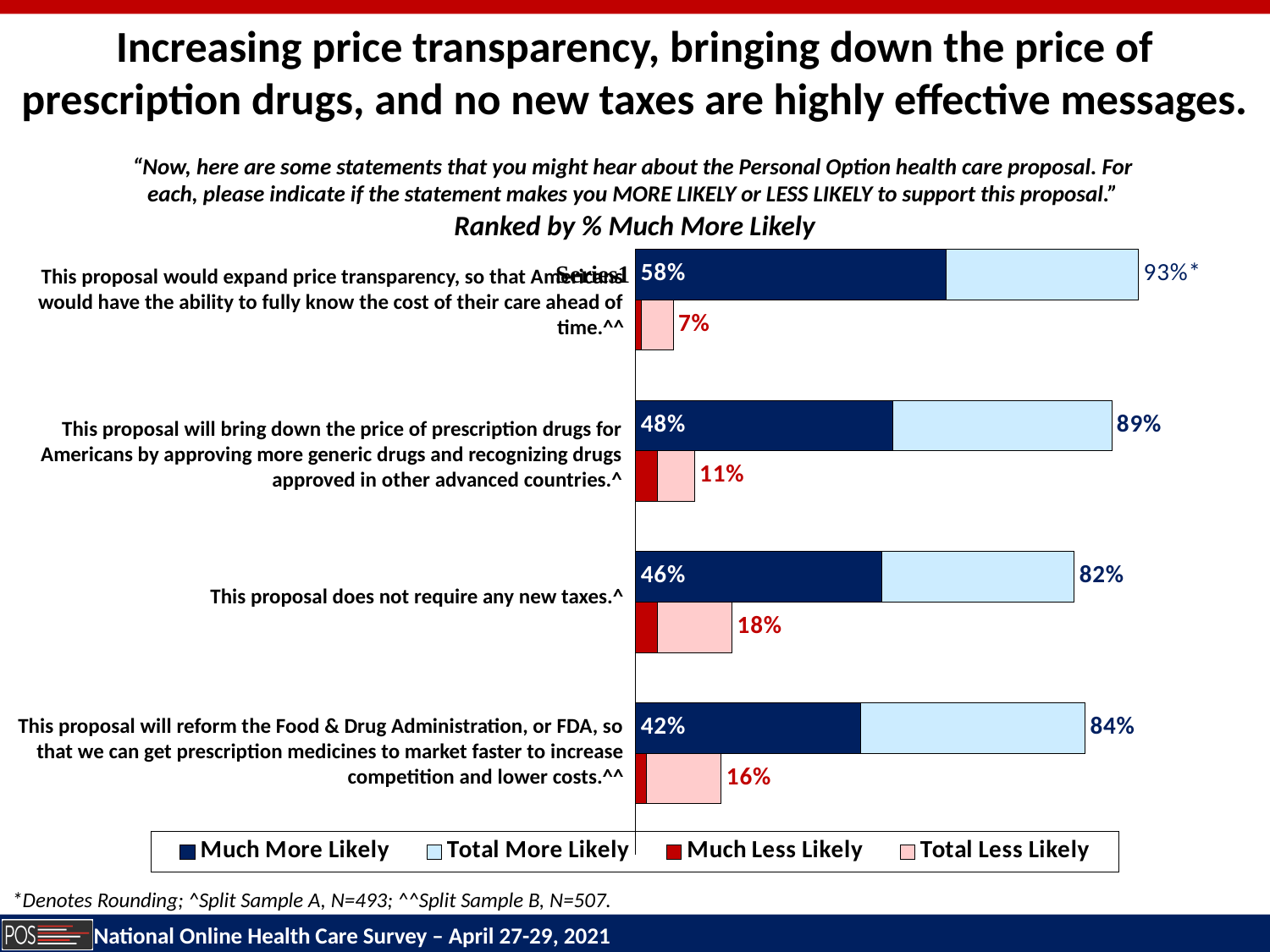
What is the Total More Likely value for the statement about reforming the FDA? 84% Which Total More Likely value is marked with an asterisk denoting rounding? 93% How many series does the legend list? 4 What type of chart is shown on the slide? Bar chart What is the difference between the Much More Likely values for the price transparency statement and the FDA reform statement? 16 percentage points Which statement has the lowest Total Less Likely percentage? This proposal would expand price transparency, so that Americans would have the ability to fully know the cost of their care ahead of time. What is the Total More Likely value for the statement that the proposal does not require any new taxes? 82% How many statements are shown in the chart? 4 What percentage of respondents said the price transparency statement makes them Much More Likely to support the proposal? 58% Which has a higher Total More Likely value: the no new taxes statement or the FDA reform statement? The FDA reform statement What is the Total Less Likely value for the statement about bringing down the price of prescription drugs? 11% Which statement has the highest Much More Likely percentage? This proposal would expand price transparency, so that Americans would have the ability to fully know the cost of their care ahead of time.